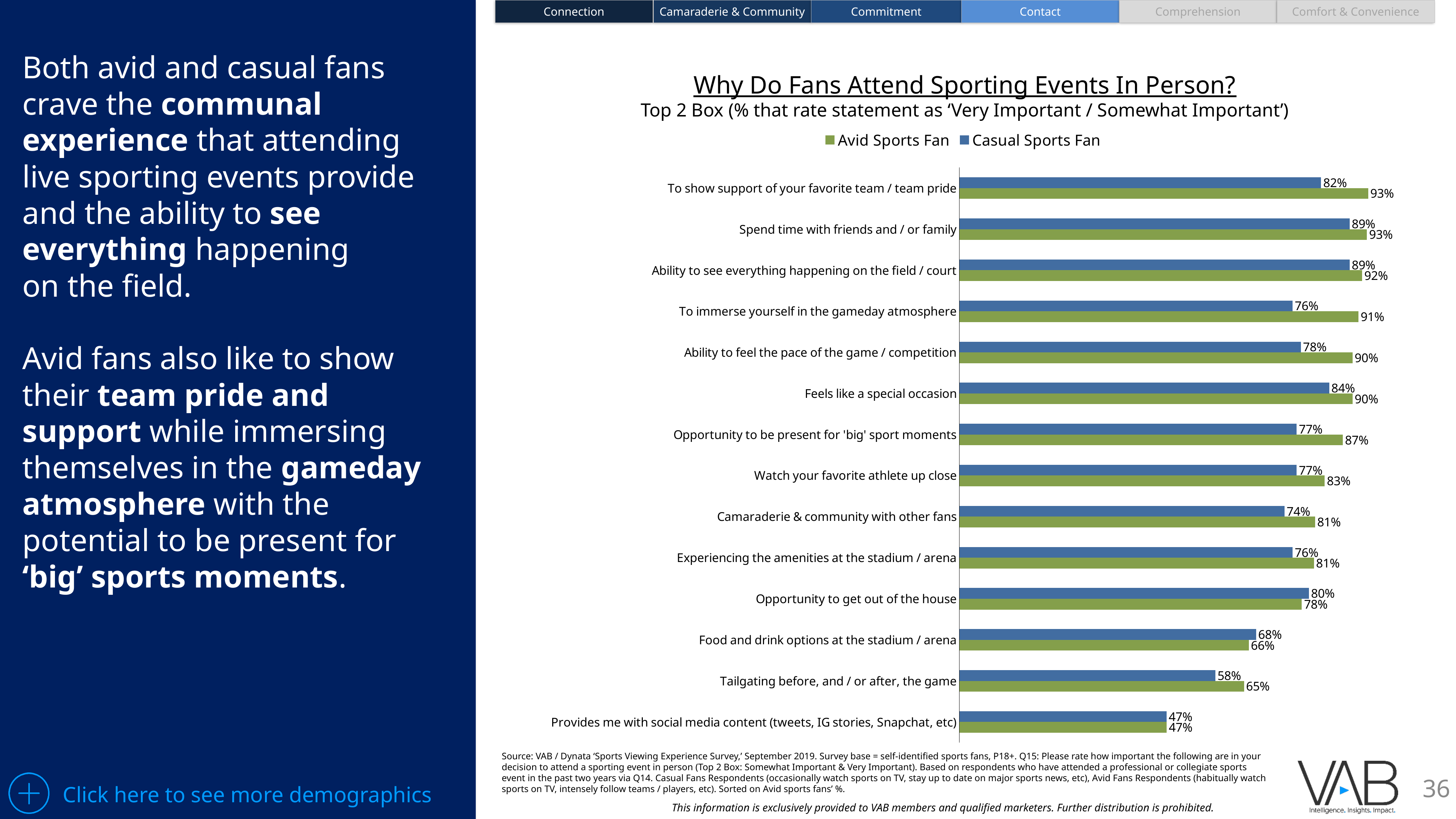
Which colour represents Avid Sports Fans in the chart? green Which reason has the lowest value for Avid Sports Fans? Provides me with social media content (tweets, IG stories, Snapchat, etc) What kind of chart is shown on the slide? bar chart What is the difference between Avid and Casual Sports Fans for 'To immerse yourself in the gameday atmosphere'? 15 percentage points What percentage of Casual Sports Fans rate 'To show support of your favorite team / team pride' as important? 82% What is the difference between Avid and Casual Sports Fans for 'To show support of your favorite team / team pride'? 11 percentage points How many series does the legend list? 2 How many reasons (categories) are plotted in the chart? 14 What is the Casual Sports Fan value for 'Tailgating before, and / or after, the game'? 58% What percentage of Avid Sports Fans rate 'To immerse yourself in the gameday atmosphere' as important? 91% For 'Ability to feel the pace of the game / competition', which group has the higher value, Avid Sports Fans or Casual Sports Fans? Avid Sports Fan For 'Opportunity to get out of the house', which group has the higher value, Avid Sports Fans or Casual Sports Fans? Casual Sports Fan